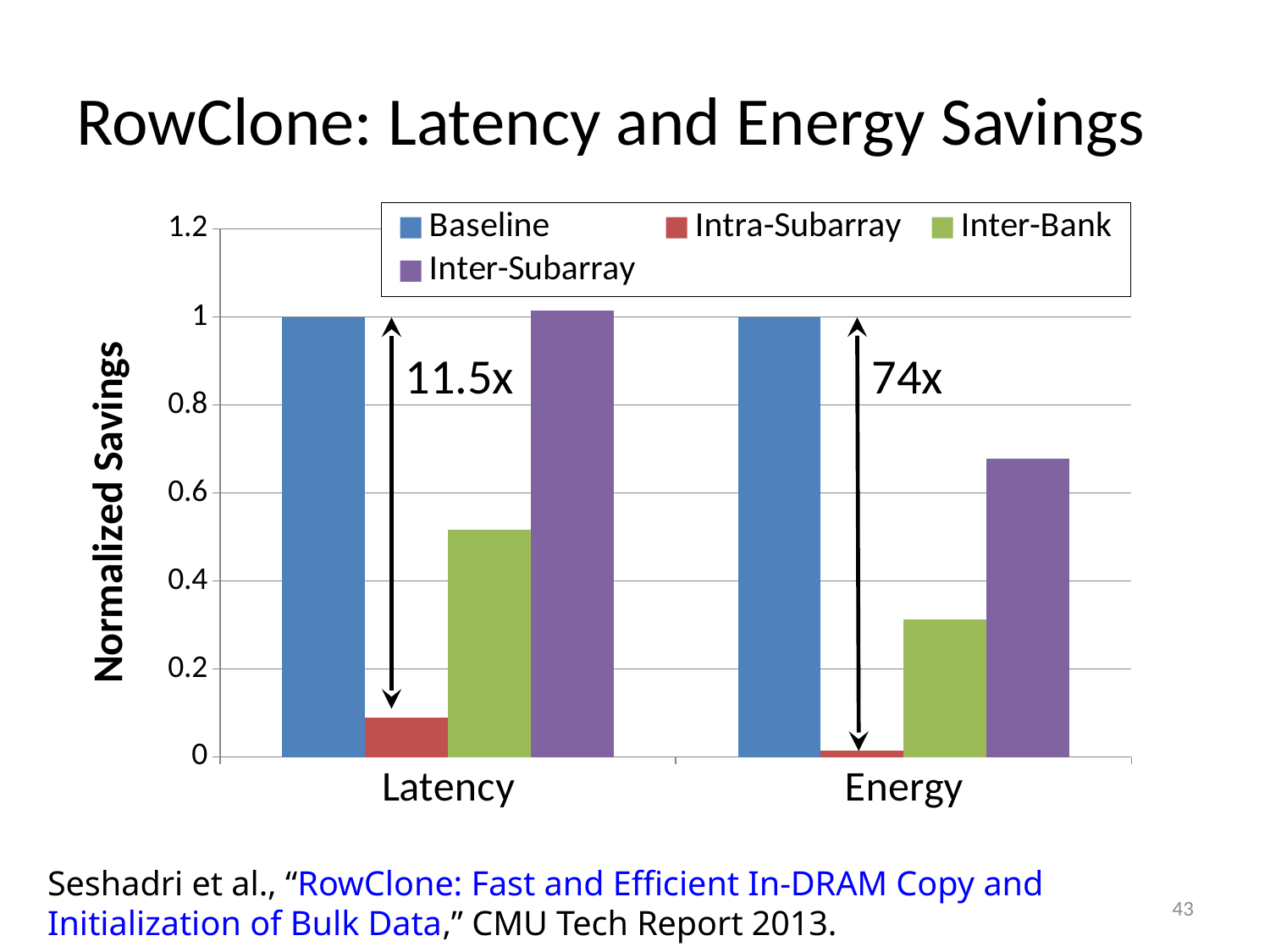
Is the Inter-Subarray value for Energy greater or less than 0.6? greater Is the Inter-Bank value larger for Latency or for Energy? Latency Is the Intra-Subarray value for Latency greater or less than 0.2? less What kind of chart is shown on the slide? bar chart Is the Inter-Bank value for Energy greater or less than 0.4? less What is the Baseline value for Energy? 1 How many series does the legend list? 4 What is the label on the y axis? Normalized Savings Which series has the lowest value for Energy? Intra-Subarray What is the Baseline value for Latency? 1 How many categories are shown on the x axis? 2